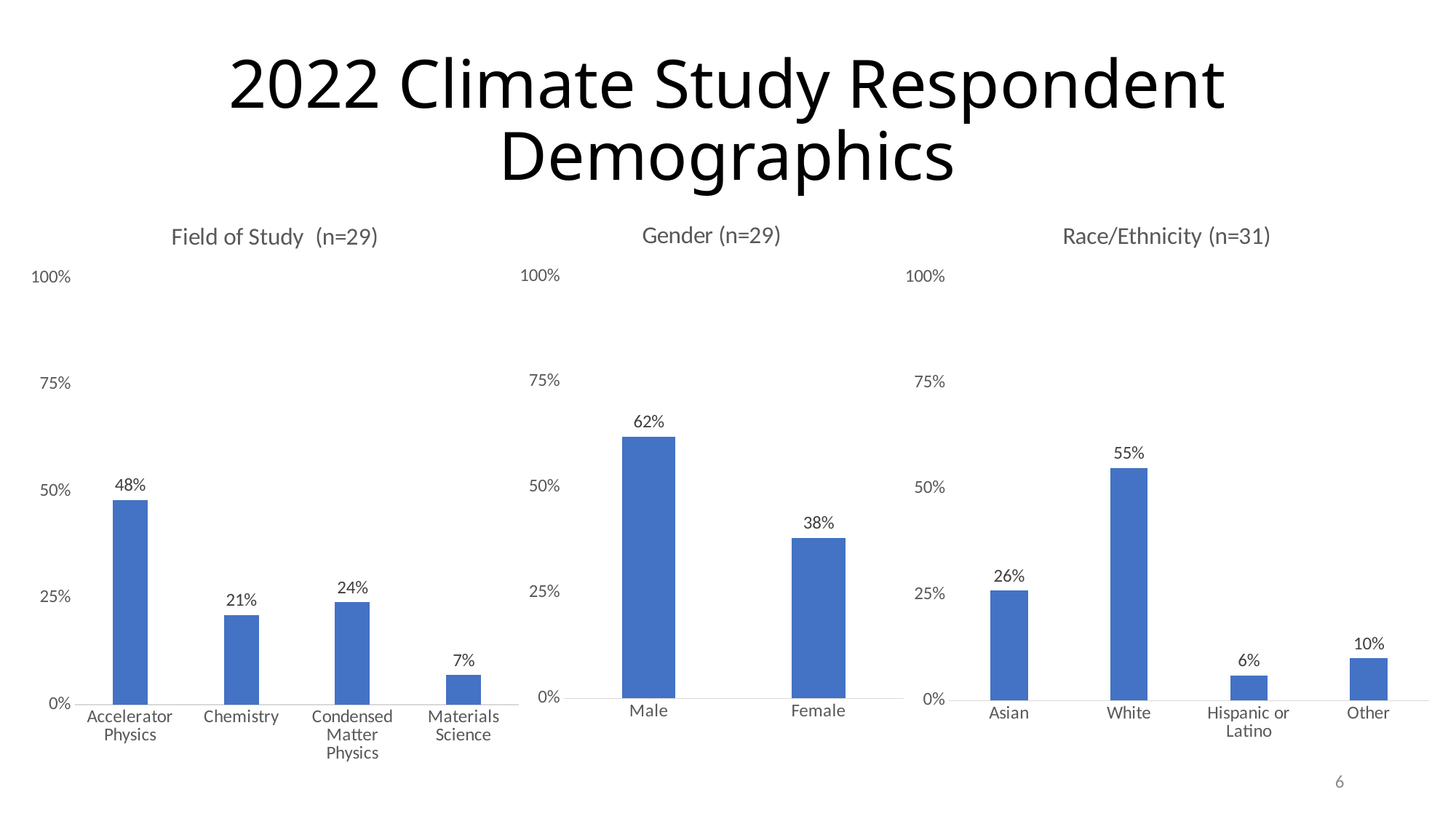
In the Race/Ethnicity (n=31) chart, which category has the highest value? White In the Field of Study (n=29) chart, what is the value for Accelerator Physics? 48% In the Race/Ethnicity (n=31) chart, what is the value for Asian? 26% In the Gender (n=29) chart, which is larger, Male or Female? Male What kind of chart is the Gender (n=29) chart? Bar chart In the Race/Ethnicity (n=31) chart, is the value for White greater or less than 50%? greater In the Gender (n=29) chart, what is the value for Female? 38% In the Gender (n=29) chart, what is the difference between Male and Female? 24% In the Field of Study (n=29) chart, what is the difference between Condensed Matter Physics and Chemistry? 3% In the Race/Ethnicity (n=31) chart, how many categories are shown? 4 In the Field of Study (n=29) chart, how many categories are shown? 4 In the Field of Study (n=29) chart, which category has the lowest value? Materials Science